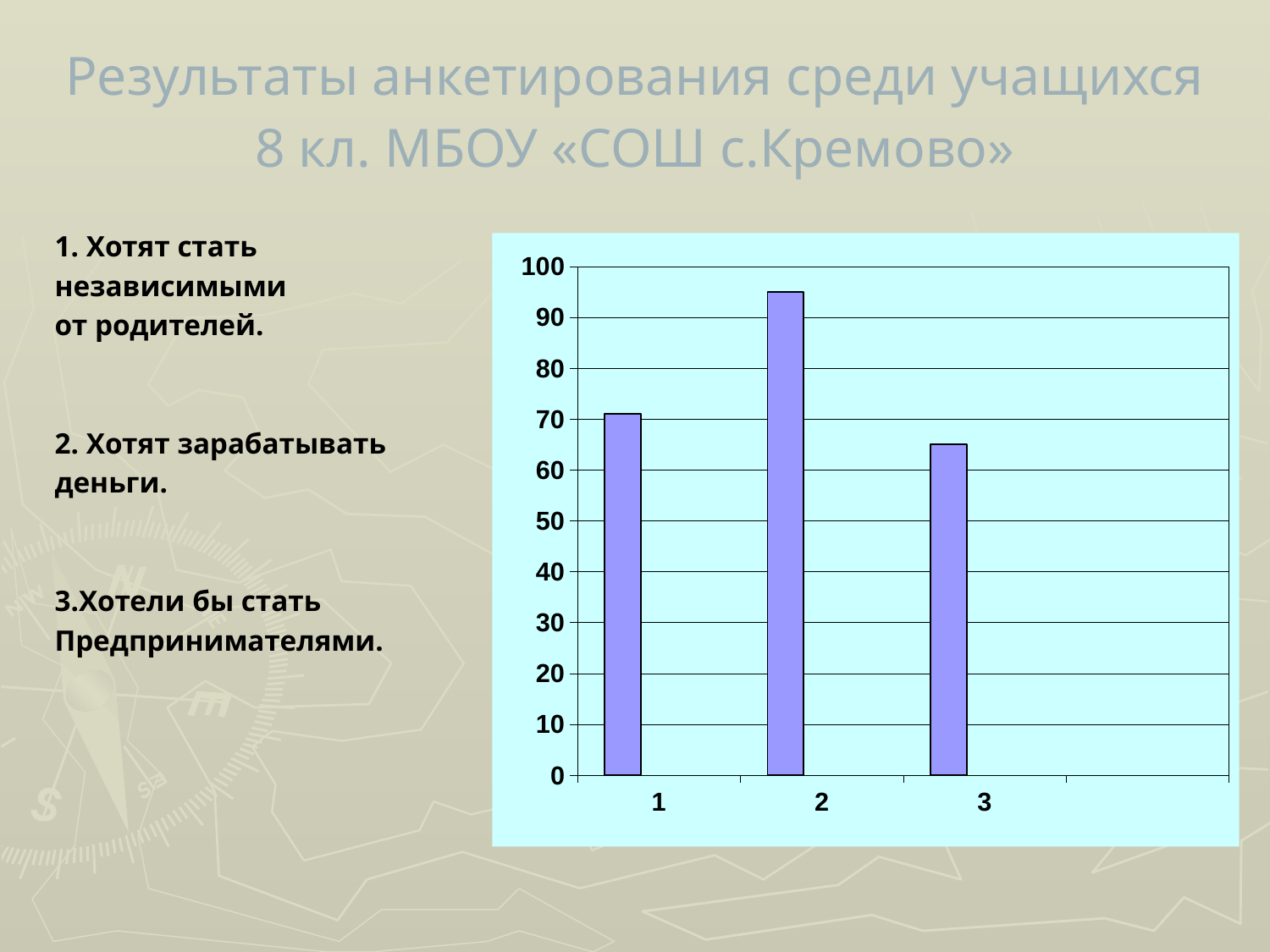
Is the value for category 3 greater or less than 60? greater Is the value for category 2 greater or less than 90? greater Is the value for category 1 greater or less than 80? less How many bars (categories) are plotted in the chart? 3 Which category has the highest bar in the chart? 2 Which category has the lowest bar in the chart? 3 Which bar is taller, category 2 or category 1? 2 What kind of chart is shown on the slide? bar chart Does the value rise or fall from category 2 to category 3? fall Which bar is taller, category 1 or category 3? 1 What is the highest value shown on the vertical axis of the chart? 100